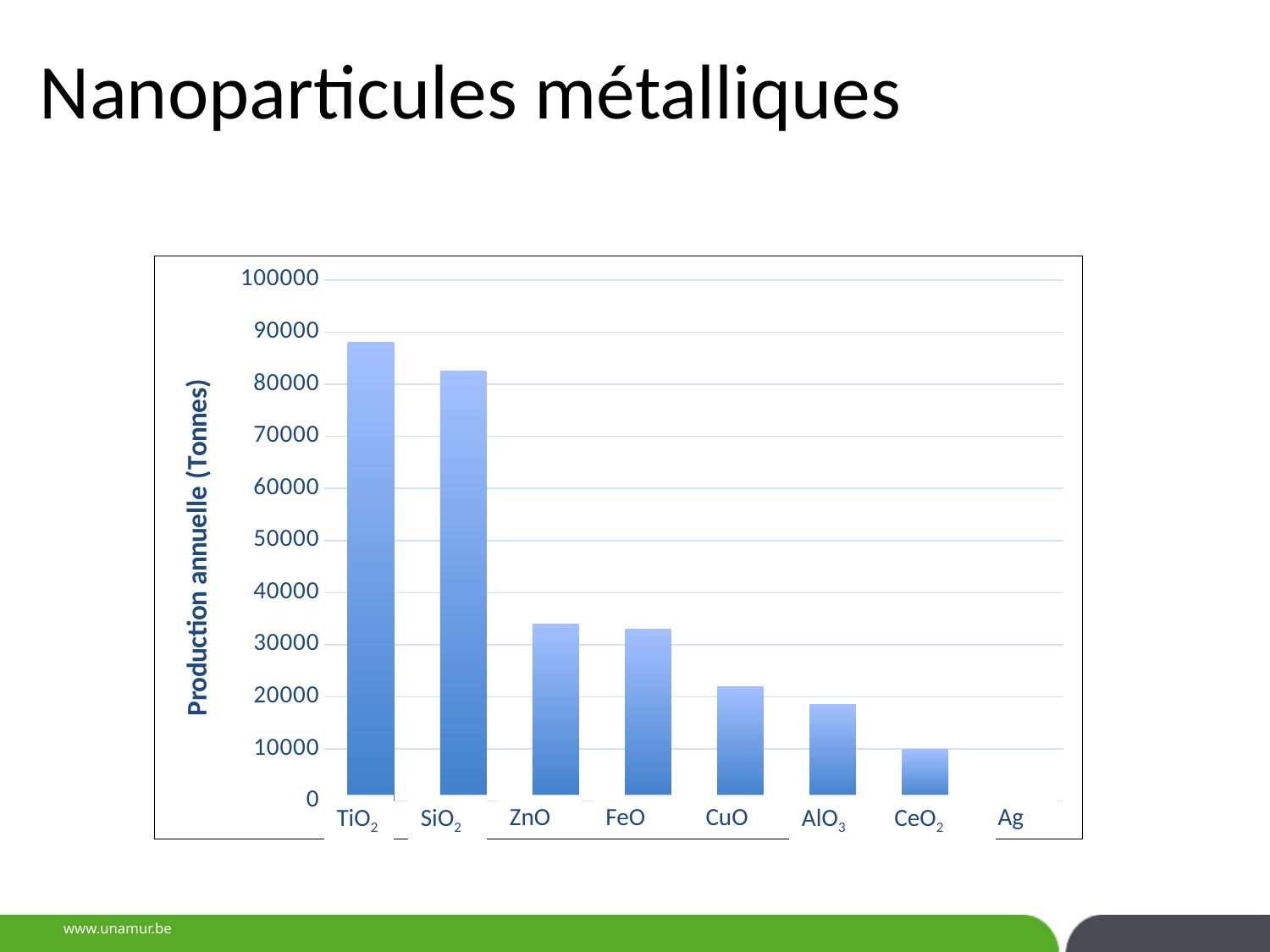
Do the values generally rise or fall from left to right along the x axis? fall Is the value for TiO2 greater or less than 80000? greater What is the title of the vertical axis of the chart? Production annuelle (Tonnes) How many categories are plotted on the x axis of the chart? 8 Is the value for ZnO greater or less than 30000? greater Is the value for AlO3 greater or less than 20000? less Which has the larger value, TiO2 or SiO2? TiO2 Which category has the lowest annual production in the chart? Ag Which category has the highest annual production in the chart? TiO2 What kind of chart is shown on the slide? bar chart Which has the larger value, CuO or AlO3? CuO Which has the larger value, ZnO or CuO? ZnO